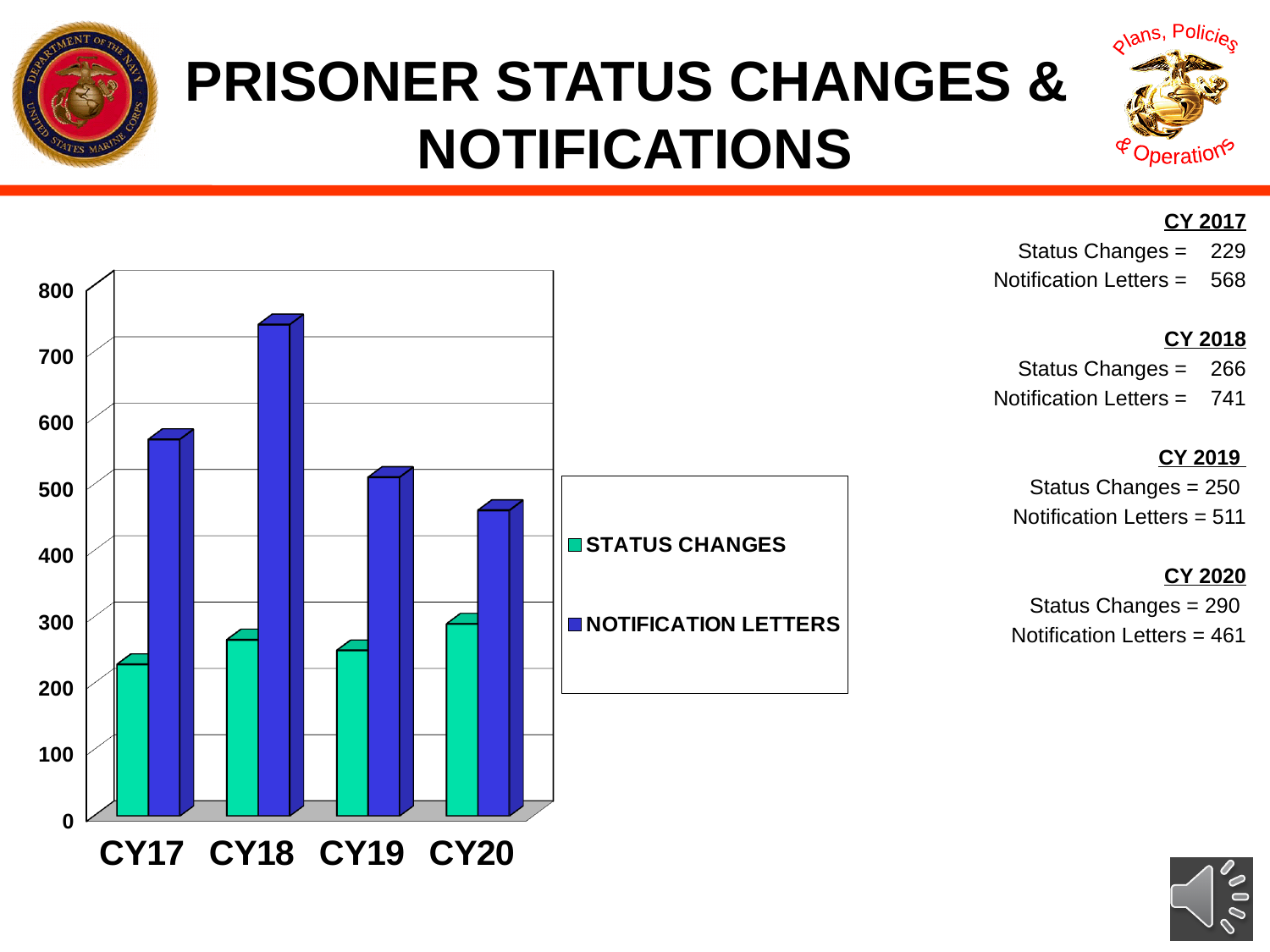
What is the value of Status Changes for CY20? 290 What is the value of Notification Letters for CY17? 568 How many series does the chart legend list? 2 What kind of chart is shown on the slide? bar chart How many calendar years are shown on the x axis of the chart? 4 Which is larger in CY20, Status Changes or Notification Letters? Notification Letters What is the difference between Notification Letters and Status Changes in CY19? 261 Do the Notification Letters values rise or fall from CY18 to CY20? fall Which year has the lowest Status Changes bar? CY17 Which year has the highest Notification Letters bar? CY18 What is the value of Notification Letters for CY18? 741 Is the Notification Letters value for CY18 greater or less than 700? greater